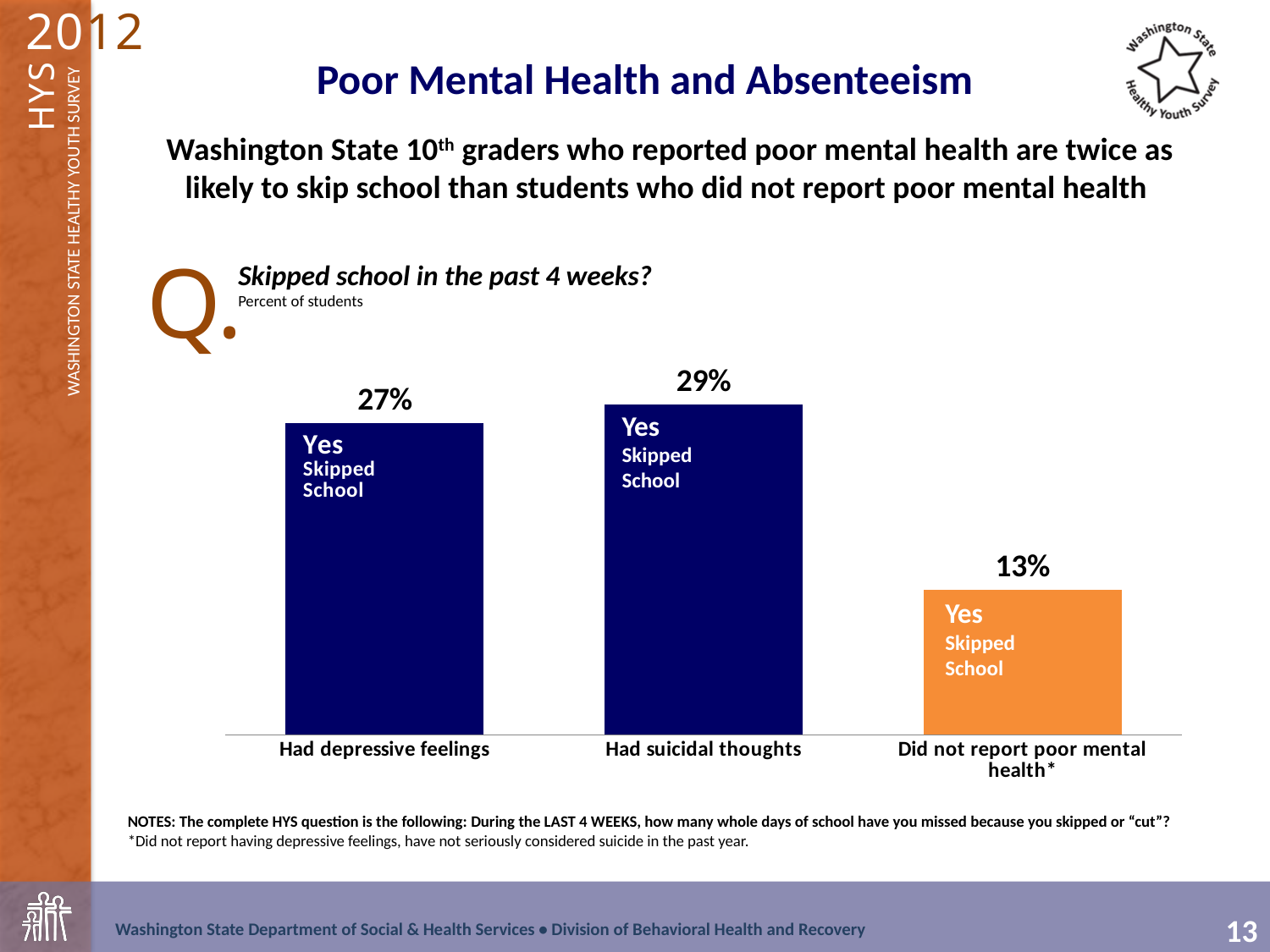
Which category has the lowest percent of students who skipped school? Did not report poor mental health* What percent of students who had depressive feelings skipped school in the past 4 weeks? 27% What is the difference in percentage points between students who had depressive feelings and students who did not report poor mental health? 14 What question does the chart report answers to? Skipped school in the past 4 weeks? What is the difference in percentage points between students who had suicidal thoughts and students who did not report poor mental health? 16 Which is larger: the value for 'Had depressive feelings' or the value for 'Did not report poor mental health*'? Had depressive feelings What percent of students who did not report poor mental health skipped school in the past 4 weeks? 13% Which category has the highest percent of students who skipped school? Had suicidal thoughts Which bar on the chart is orange rather than dark blue? Did not report poor mental health* How many categories are shown on the chart? 3 What kind of chart is shown on the slide? Bar chart What percent of students who had suicidal thoughts skipped school in the past 4 weeks? 29%